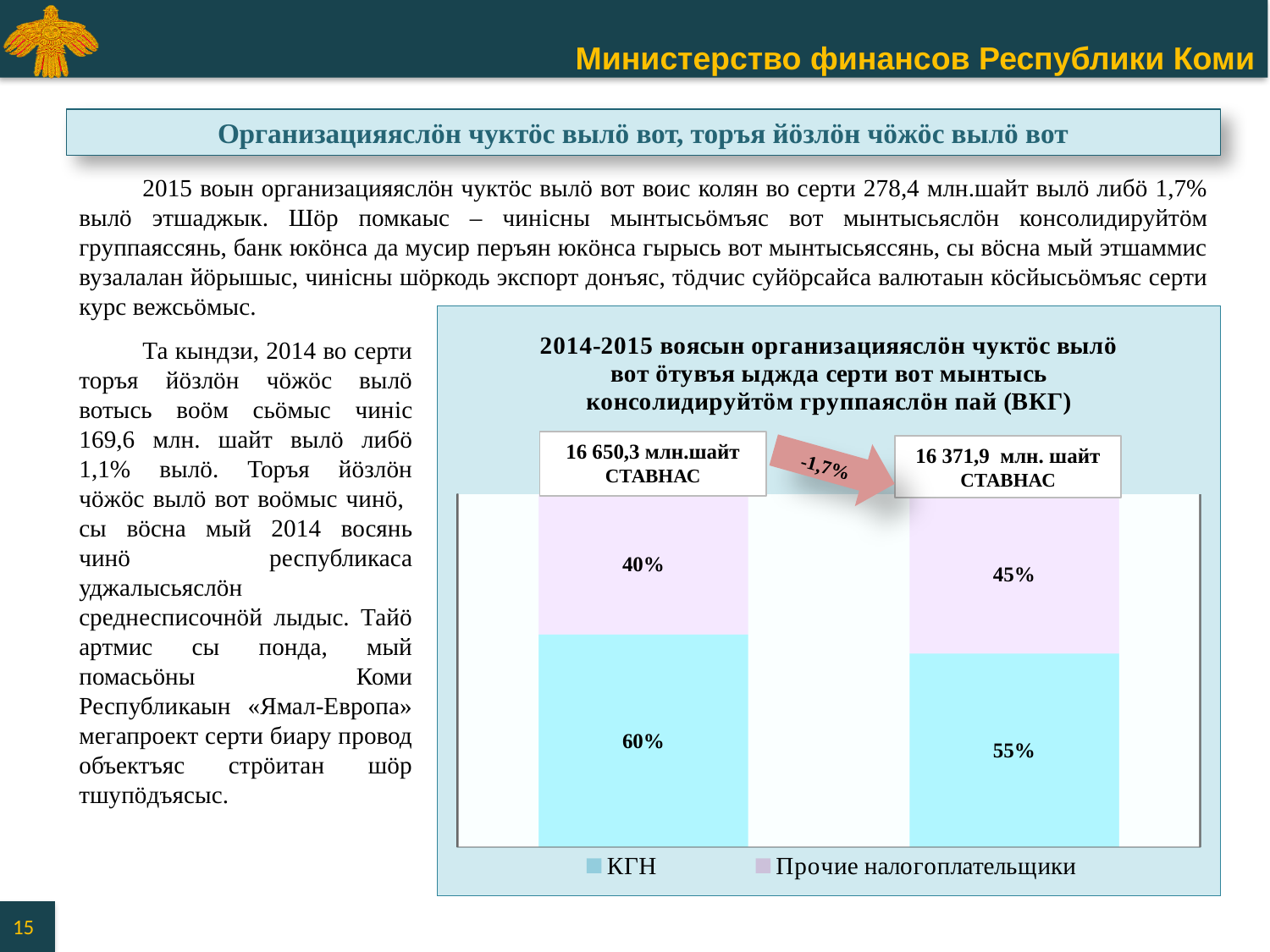
What is the КГН share in the left bar (16 650,3 млн.шайт)? 60% What is the КГН share in the right bar (16 371,9 млн. шайт)? 55% What is the total of the two segments in the left bar? 100% Which bar has the larger Прочие налогоплательщики share, the left or the right? right By how many percentage points does the КГН share in the left bar exceed the КГН share in the right bar? 5 What is the Прочие налогоплательщики share in the left bar? 40% How many series does the chart legend list? 2 What is the Прочие налогоплательщики share in the right bar? 45% What kind of chart is shown on the slide? stacked bar chart How many bars are plotted in the chart? 2 Which legend entry is shown in pink? Прочие налогоплательщики What percentage change is shown on the arrow between the two bars? -1,7%